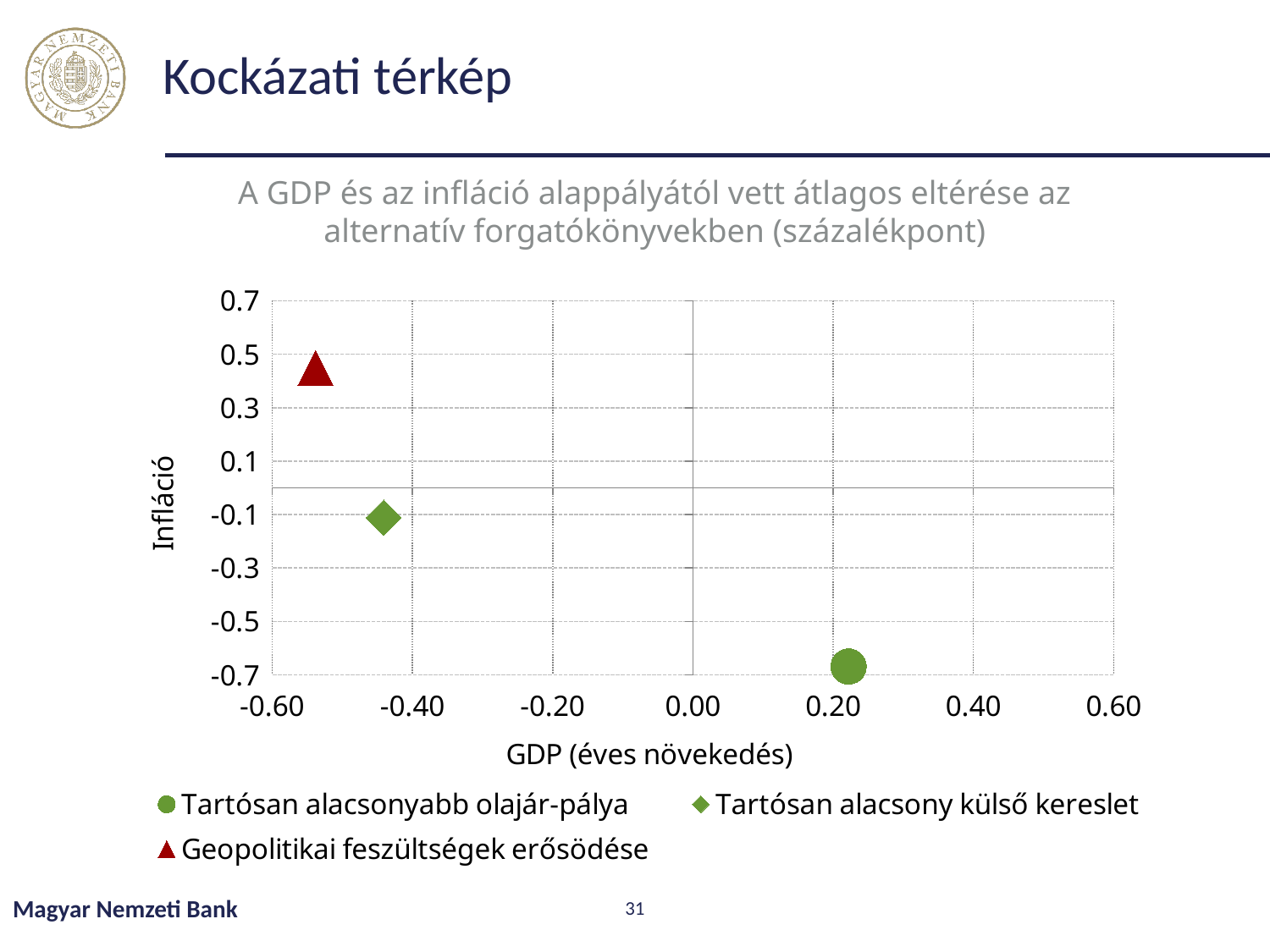
What is the label of the horizontal axis? GDP (éves növekedés) Is the inflation value for Tartósan alacsonyabb olajár-pálya greater or less than -0.5? less Is the inflation value for Geopolitikai feszültségek erősödése greater or less than 0.3? greater What kind of chart is shown on the slide? scatter chart How many series does the legend list? 3 Is the GDP value for Tartósan alacsony külső kereslet greater or less than -0.20? less Which has a higher inflation value, Geopolitikai feszültségek erősödése or Tartósan alacsony külső kereslet? Geopolitikai feszültségek erősödése Which series has the lowest inflation value? Tartósan alacsonyabb olajár-pálya How many data points are plotted on the chart? 3 Which series has the highest inflation value? Geopolitikai feszültségek erősödése Which series has the highest GDP value? Tartósan alacsonyabb olajár-pálya